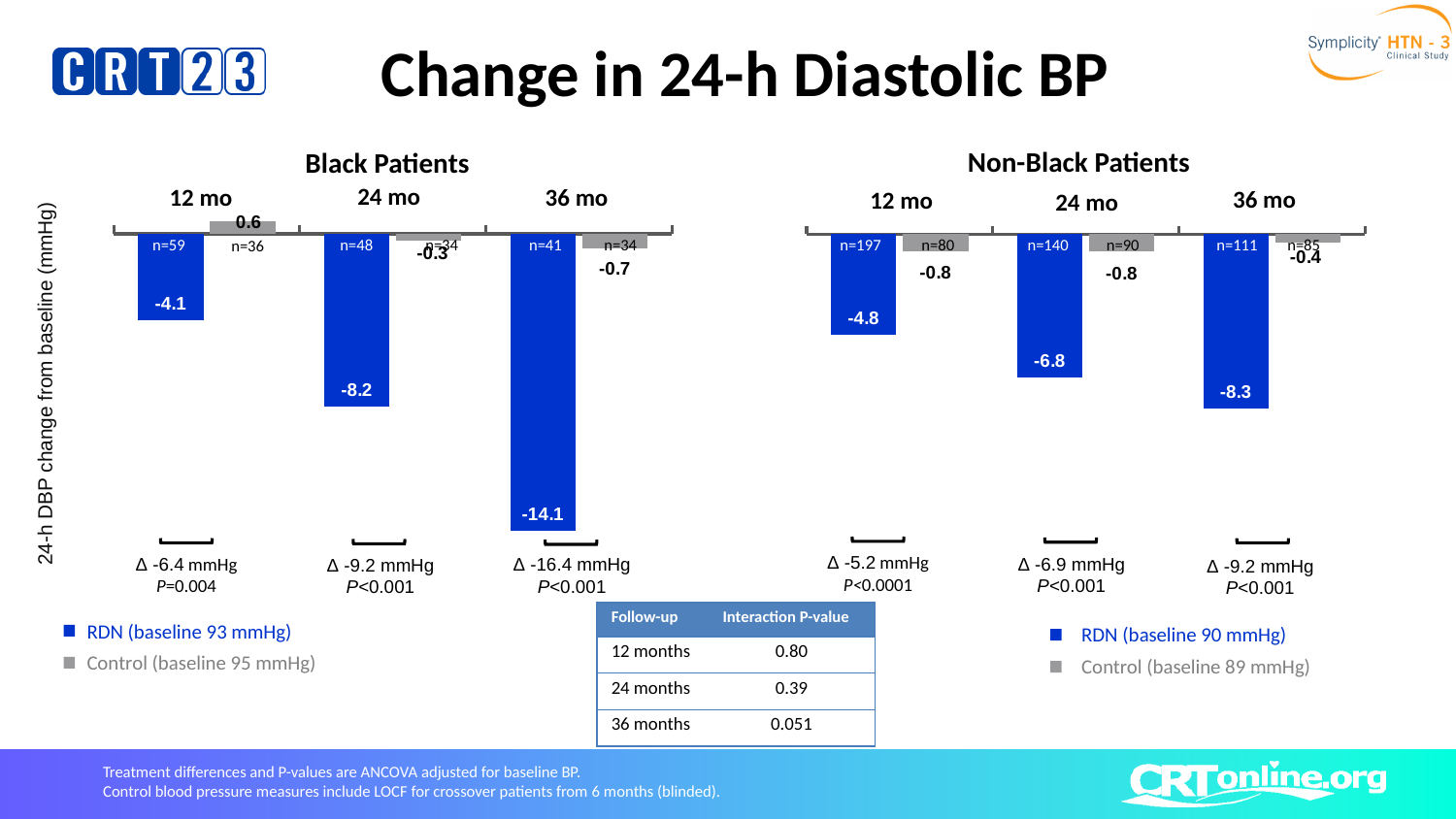
In the Black Patients chart, what is the Control value at 12 months? 0.6 In the Black Patients chart, what is the difference between the RDN values at 36 months and 12 months? 10 In the Black Patients chart, what is the 24-h DBP change for RDN at 36 months? -14.1 In the Non-Black Patients chart, what is the Control value at 36 months? -0.4 Which has a larger reduction at 24 months: RDN in the Black Patients chart or RDN in the Non-Black Patients chart? Black Patients How many series does the legend of the Non-Black Patients chart list? 2 What type of chart is used for the Black Patients data? Bar chart How many time points are shown in the Black Patients chart? 3 In the Non-Black Patients chart, at which time point is the RDN reduction smallest? 12 mo In the Non-Black Patients chart, what is the difference between the RDN and Control values at 36 months? 7.9 In the Black Patients chart, at which time point is the RDN change from baseline the largest reduction? 36 mo In the Non-Black Patients chart, what is the 24-h DBP change for RDN at 24 months? -6.8